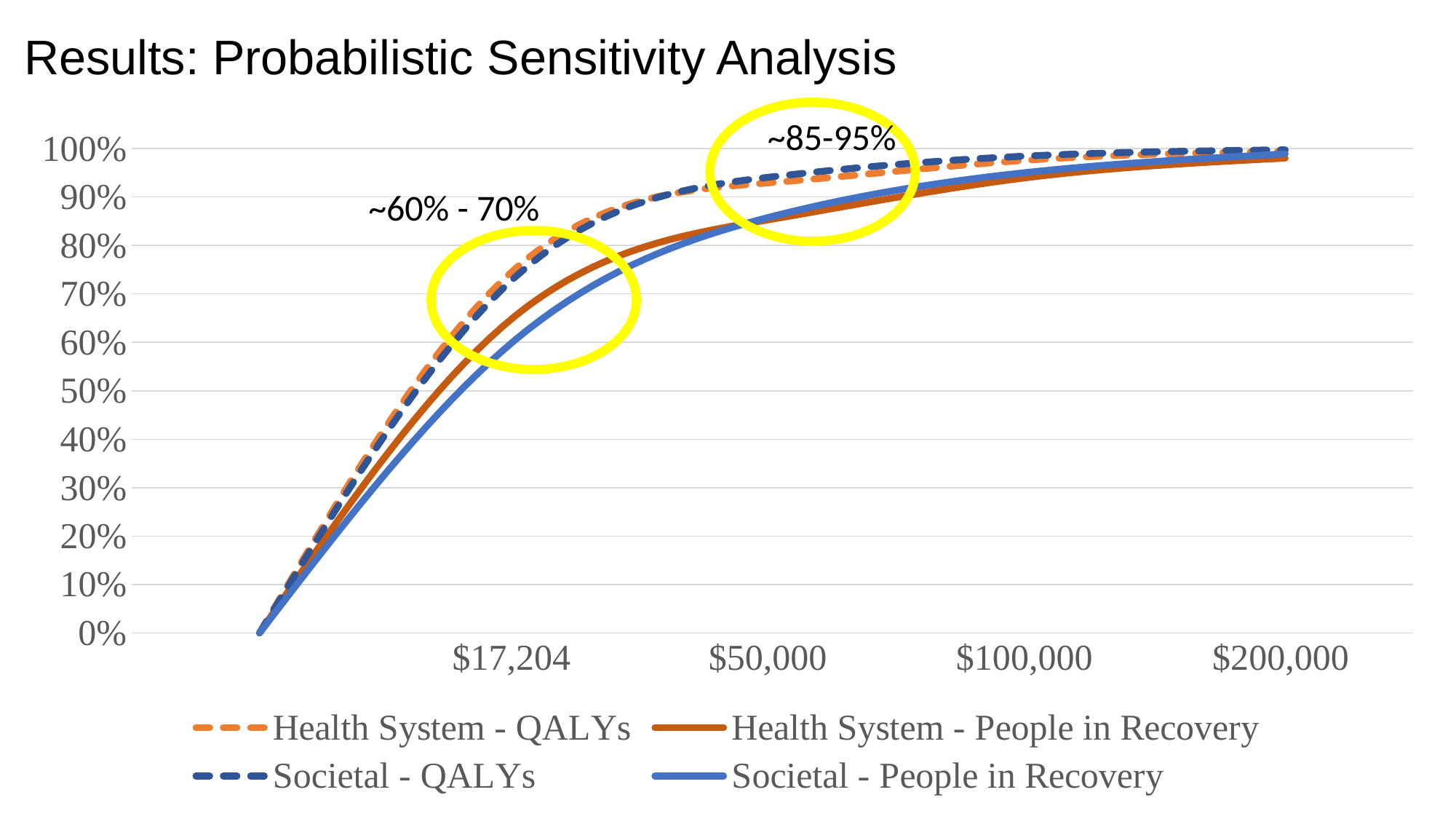
Which two series are drawn with dashed lines? Health System - QALYs and Societal - QALYs At $17,204, which is higher: Societal - QALYs or Societal - People in Recovery? Societal - QALYs Do the values of the lines rise or fall as the x-axis value increases? Rise At $50,000, which is higher: Health System - QALYs or Health System - People in Recovery? Health System - QALYs Is the value for Health System - People in Recovery at $100,000 greater or less than 80%? greater How many series does the legend list? 4 Is the value for Societal - QALYs at $50,000 greater or less than 80%? greater What text is written inside the upper yellow circle annotation? ~85-95% Is the value for Health System - QALYs at $17,204 greater or less than 50%? greater How many labelled tick values are shown on the x axis? 4 What kind of chart is shown on the slide? Line chart